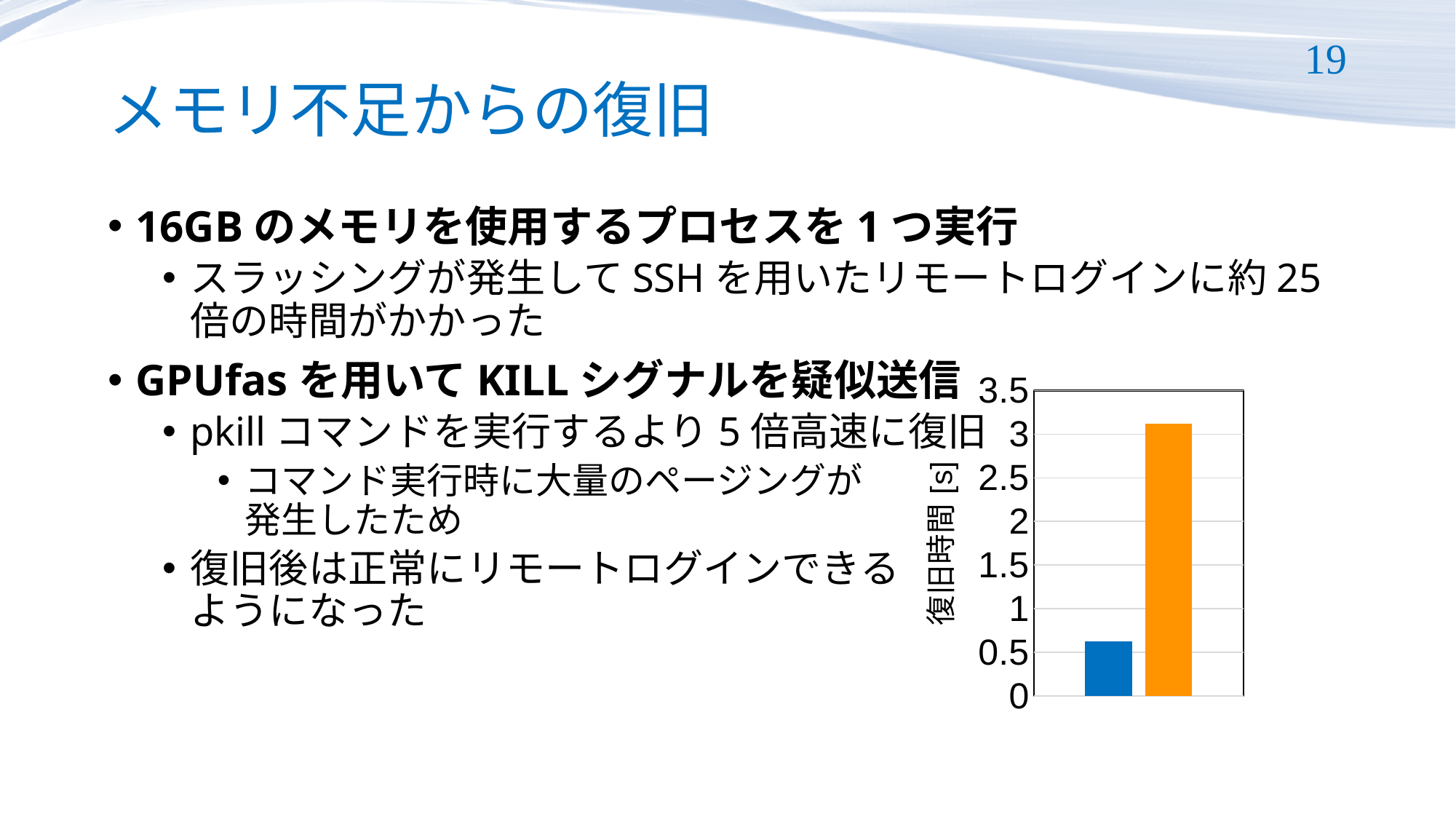
Which bar shows the highest recovery time in the chart? the orange bar Is the value of the blue bar greater or less than 1? less How many bars are plotted in the chart? 2 Which bar shows the lowest recovery time in the chart? the blue bar What is the maximum value shown on the vertical axis of the chart? 3.5 Is the value of the orange bar greater or less than 2.5? greater Is the value of the orange bar greater or less than 3.5? less What is the label of the vertical axis of the chart? 復旧時間 [s] What kind of chart is shown on the slide? bar chart Which bar is taller in the chart, the blue bar or the orange bar? the orange bar